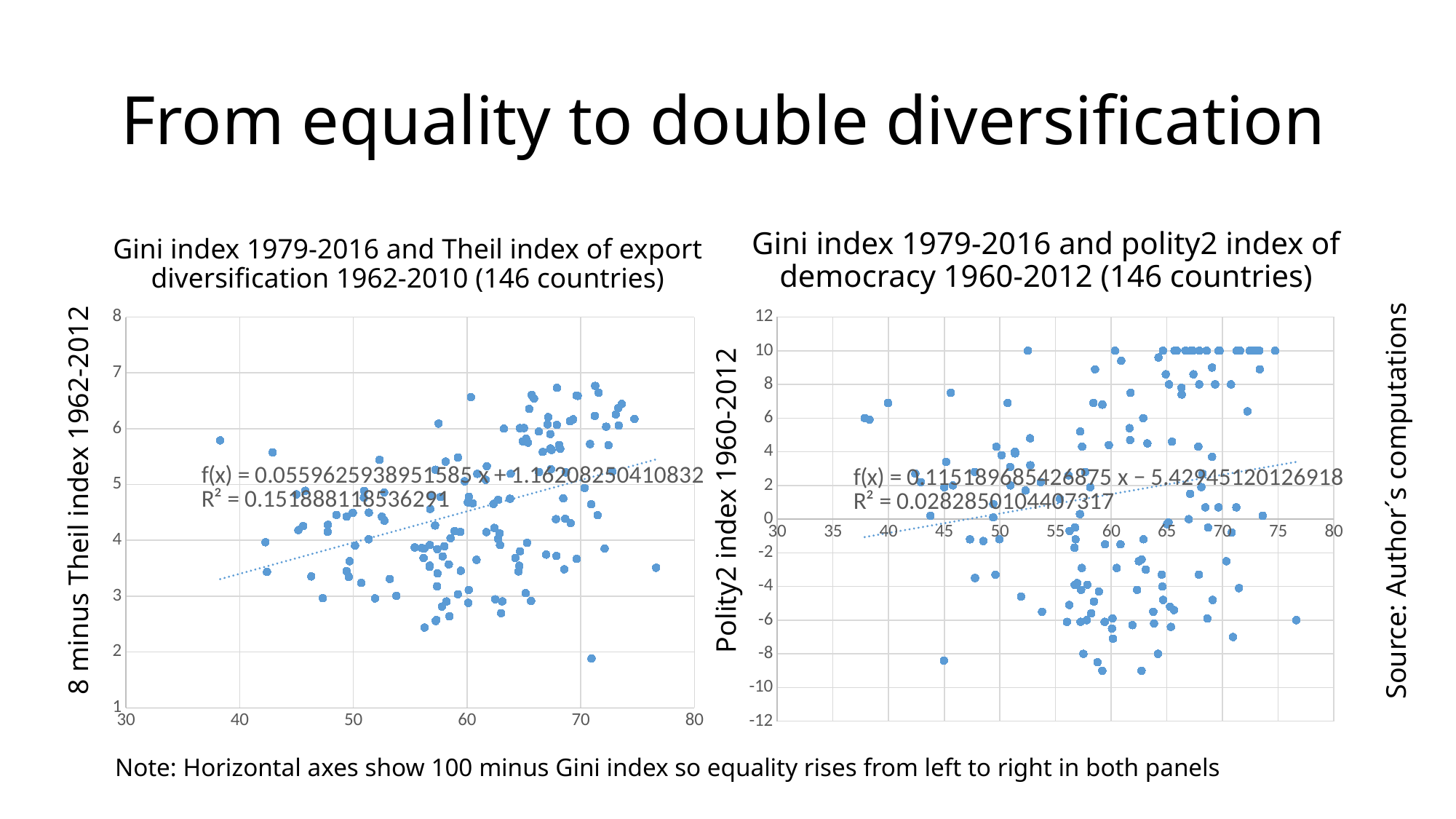
What kind of chart is the right chart, titled 'Gini index 1979-2016 and polity2 index of democracy 1960-2012 (146 countries)'? Scatter chart What R² value is printed on the right chart (polity2 index of democracy)? 0.0282850104407317 In the right chart (polity2 index of democracy), does the fitted trend line rise or fall from left to right? Rises What kind of chart is the left chart, titled 'Gini index 1979-2016 and Theil index of export diversification 1962-2010 (146 countries)'? Scatter chart In the left chart (Theil index of export diversification), is the lowest plotted point greater or less than 2 on the vertical axis? less In the right chart (polity2 index of democracy), is the lowest plotted point greater or less than -8 on the vertical axis? less In the left chart (Theil index of export diversification), does the fitted trend line rise or fall as the horizontal axis value increases? Rises What R² value is printed on the left chart (Theil index of export diversification)? 0.151888118536291 Which chart has the higher R² value, the left chart (Theil index) or the right chart (polity2 index)? The left chart (Theil index) In the right chart (polity2 index of democracy), what is the highest polity2 value reached by the plotted points? 10 What is the vertical axis label of the left chart? 8 minus Theil index 1962-2012 According to the chart titles, how many countries are included in each chart? 146 countries